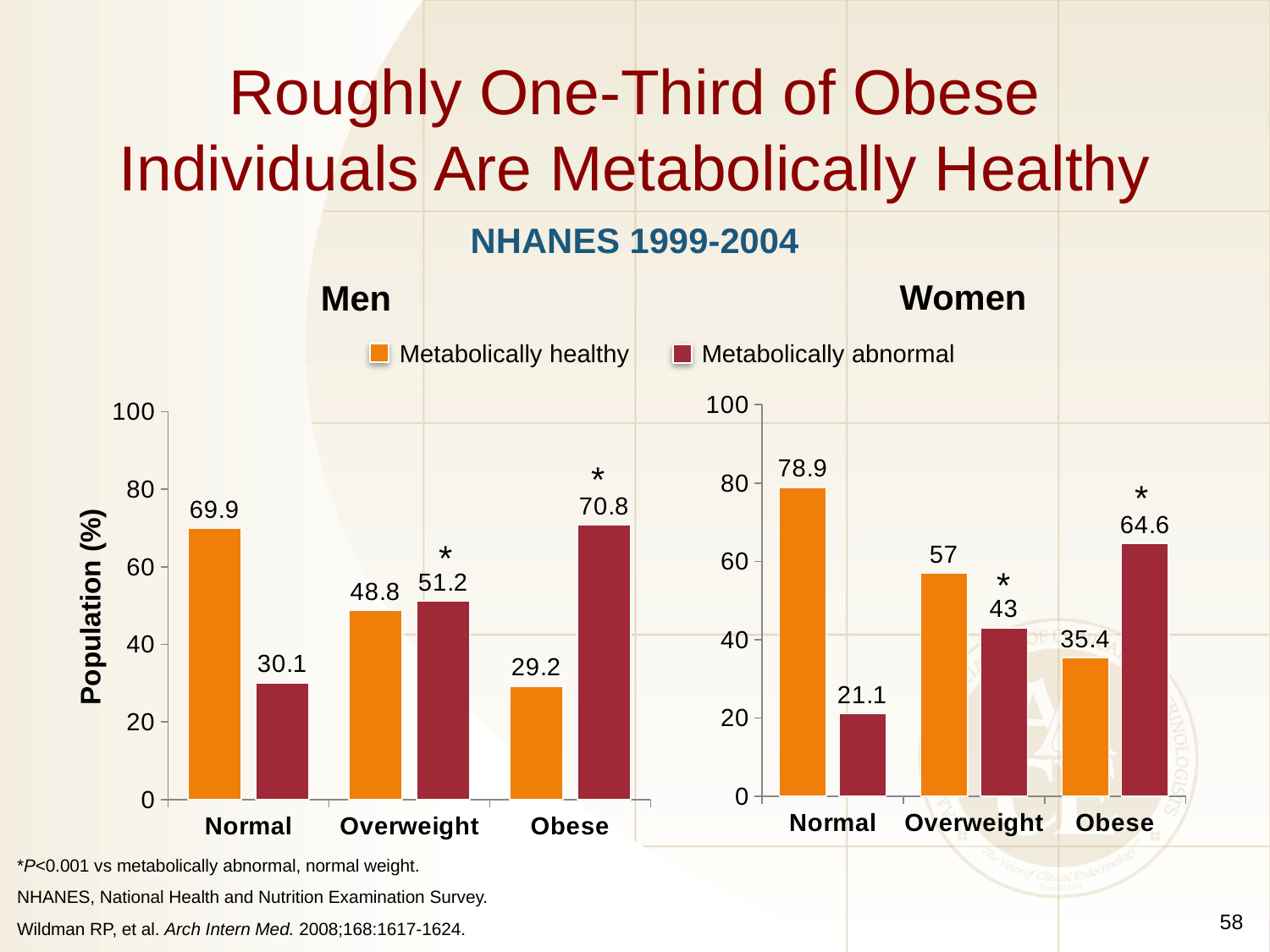
In the Men chart, which category has the lowest Metabolically abnormal value? Normal What kind of chart is the Women chart? bar chart In the Men chart, what is the value for Metabolically abnormal in the Overweight category? 51.2 In the Women chart, what is the difference between the Metabolically healthy and Metabolically abnormal values in the Normal category? 57.8 In the Men chart, which is larger in the Obese category: Metabolically healthy or Metabolically abnormal? Metabolically abnormal How many series does the legend list? 2 In the Men chart, what is the value for Metabolically healthy in the Normal category? 69.9 How many categories are shown on the x axis of the Men chart? 3 In the Women chart, is the Metabolically healthy value for Obese greater or less than 40? less In the Women chart, what is the value for Metabolically abnormal in the Obese category? 64.6 In the Women chart, which category has the highest Metabolically healthy value? Normal In the Men chart, does the Metabolically healthy value rise or fall from Normal to Obese? fall